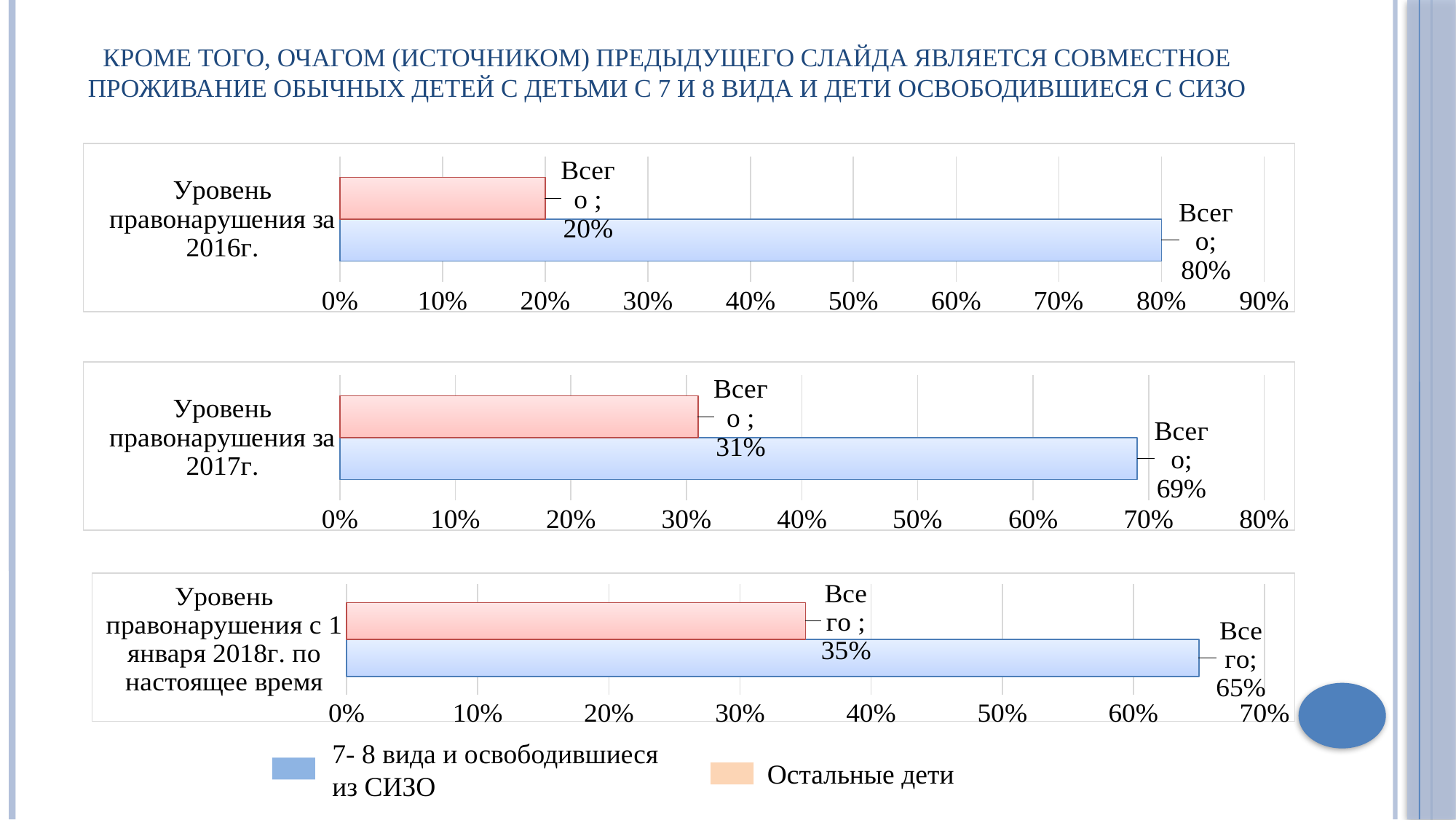
In the bottom chart (Уровень правонарушения с 1 января 2018г. по настоящее время), what is the value of the pink bar? 35% How many charts are shown on the slide? 3 In the middle chart (Уровень правонарушения за 2017г.), what is the value of the pink bar? 31% In the bottom chart (Уровень правонарушения с 1 января 2018г. по настоящее время), what is the value of the blue bar? 65% In the top chart (Уровень правонарушения за 2016г.), what is the value of the pink bar? 20% In the bottom chart (2018г.), what is the difference between the blue bar and the pink bar? 30% According to the legend, which group does the blue colour represent? 7- 8 вида и освободившиеся из СИЗО In the middle chart (Уровень правонарушения за 2017г.), what is the value of the blue bar? 69% What kind of chart is used on this slide? bar chart In the top chart (Уровень правонарушения за 2016г.), what is the value of the blue bar? 80% In the middle chart (2017г.), which bar is larger, the blue one or the pink one? the blue one In the top chart (2016г.), what is the difference between the blue bar and the pink bar? 60%